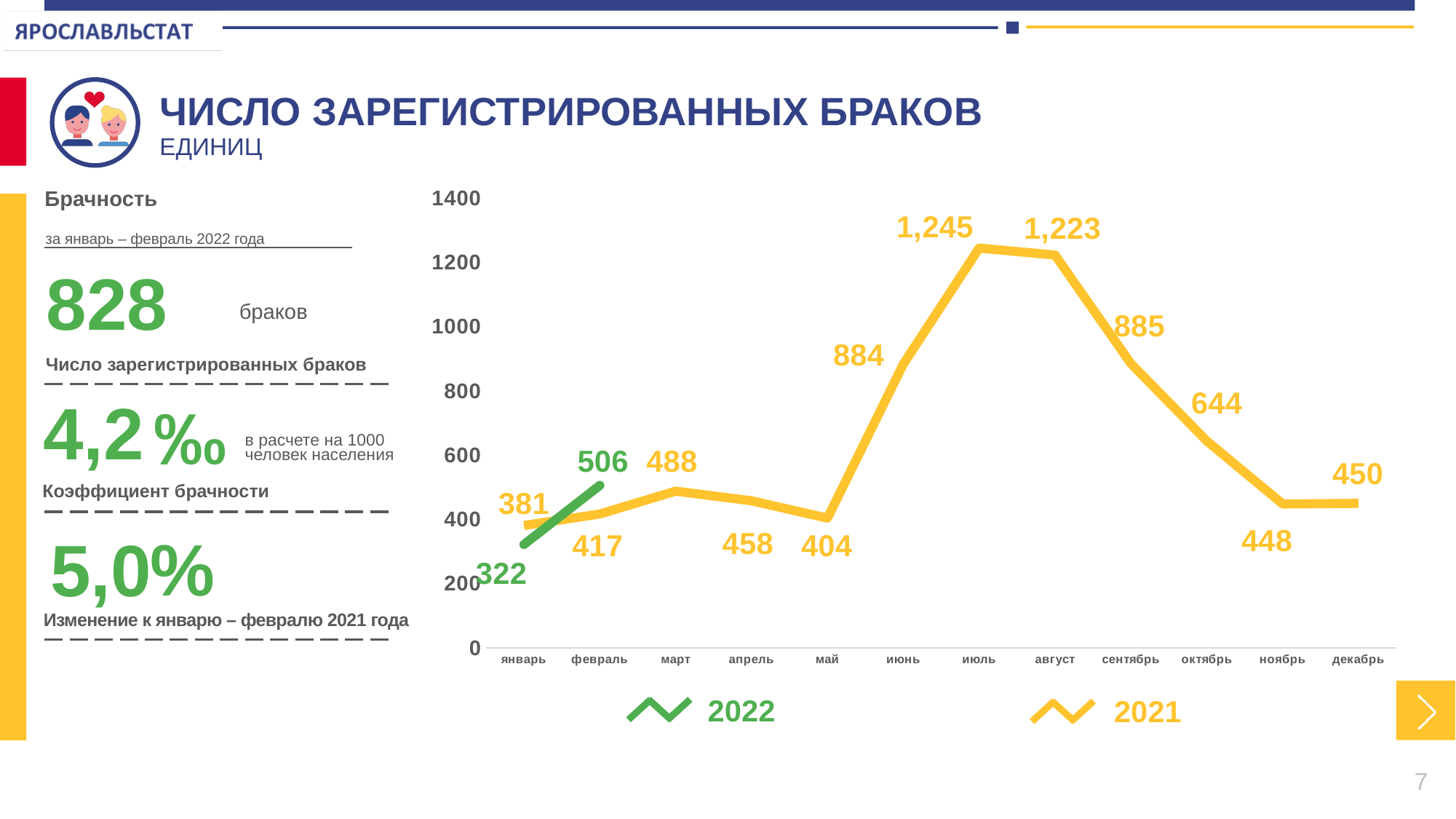
What is the value for январь in the 2021 series? 381 Which month has the highest value in the 2021 series? июль How many series does the legend list? 2 Which month has the lowest value in the 2021 series? январь Does the 2022 series rise or fall from январь to февраль? rise What is the difference between the 2022 and 2021 values for февраль? 89 What colour is the line for the 2021 series? yellow Which is larger for январь: the 2022 value or the 2021 value? 2021 What is the value for февраль in the 2022 series? 506 What type of chart is shown on the slide? line chart How many months are shown on the x axis? 12 What is the value for июль in the 2021 series? 1,245